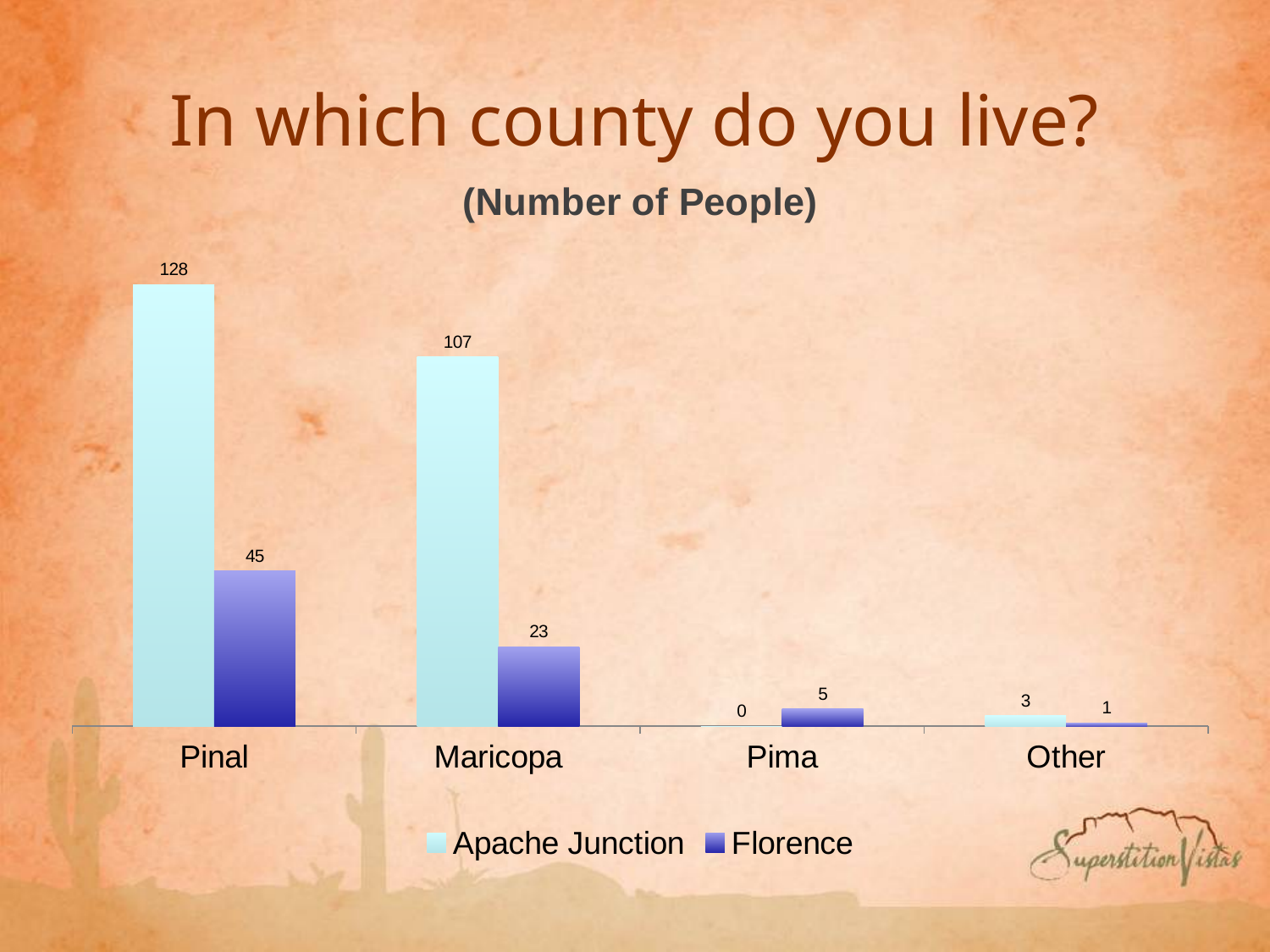
What is the value for Florence in the Pima category? 5 How many people from Apache Junction live in Pinal county? 128 What is the subtitle shown under the chart title? (Number of People) Which county has the highest value for Apache Junction? Pinal What is the difference between the Apache Junction and Florence values for Pinal? 83 Which is larger for Maricopa: the Apache Junction value or the Florence value? Apache Junction How many series does the legend list? 2 How many people from Florence live in Maricopa county? 23 What is the difference between the Apache Junction values for Pinal and Maricopa? 21 What kind of chart is shown on the slide? Bar chart How many counties are shown on the x axis? 4 Which county has the lowest value for Florence? Other